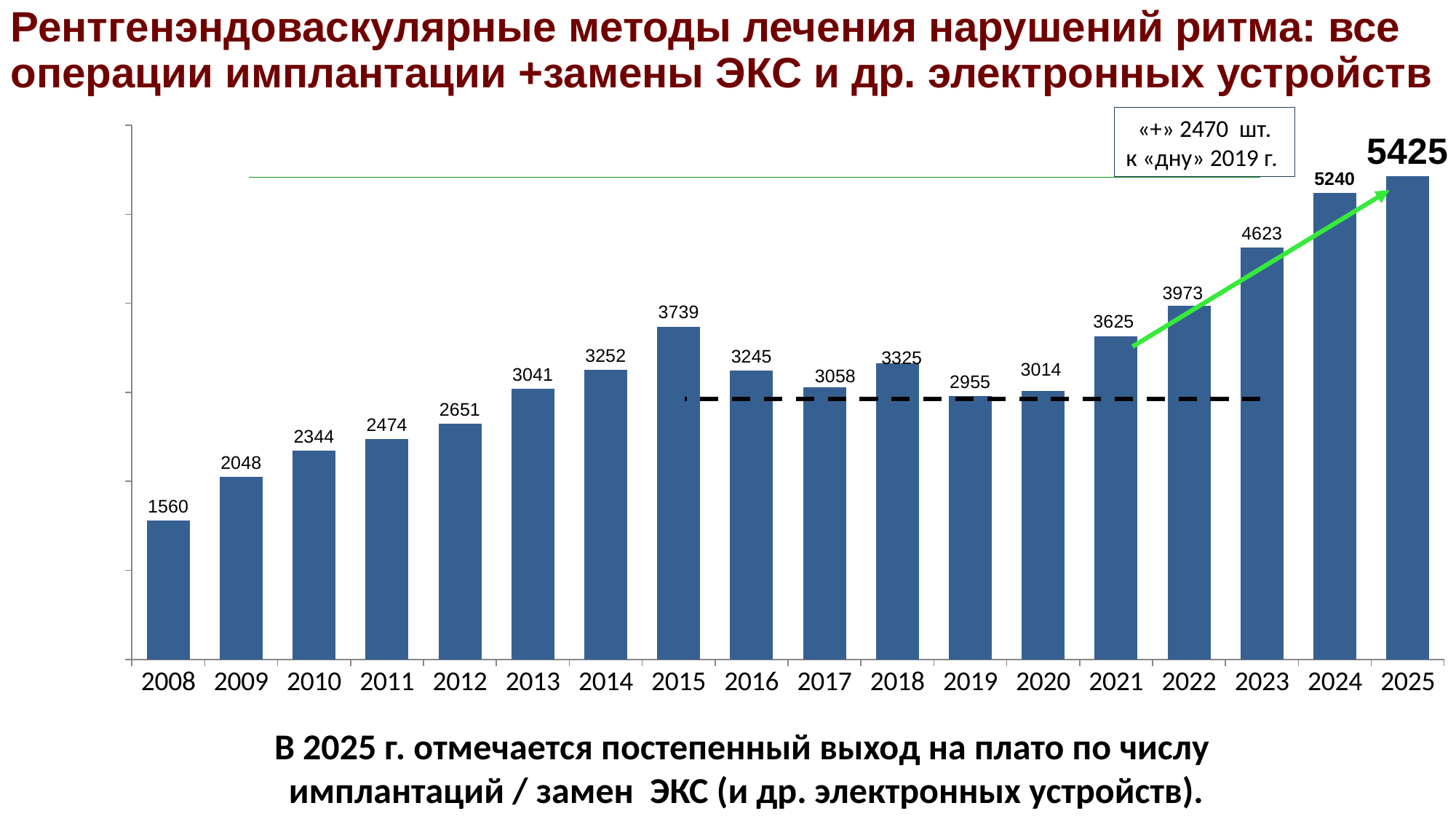
What is the value for 2025? 5425 What is the difference between the values for 2021 and 2019? 670 What kind of chart is shown on the slide? bar chart Do the values rise or fall from 2021 to 2025? rise Which is larger, the value for 2015 or the value for 2018? 2015 Which year has the lowest value? 2008 What is the value for 2008? 1560 What is the value for 2019? 2955 Which year has the highest value? 2025 What is the value for 2015? 3739 How many years are shown on the x axis? 18 What is the difference between the values for 2025 and 2024? 185